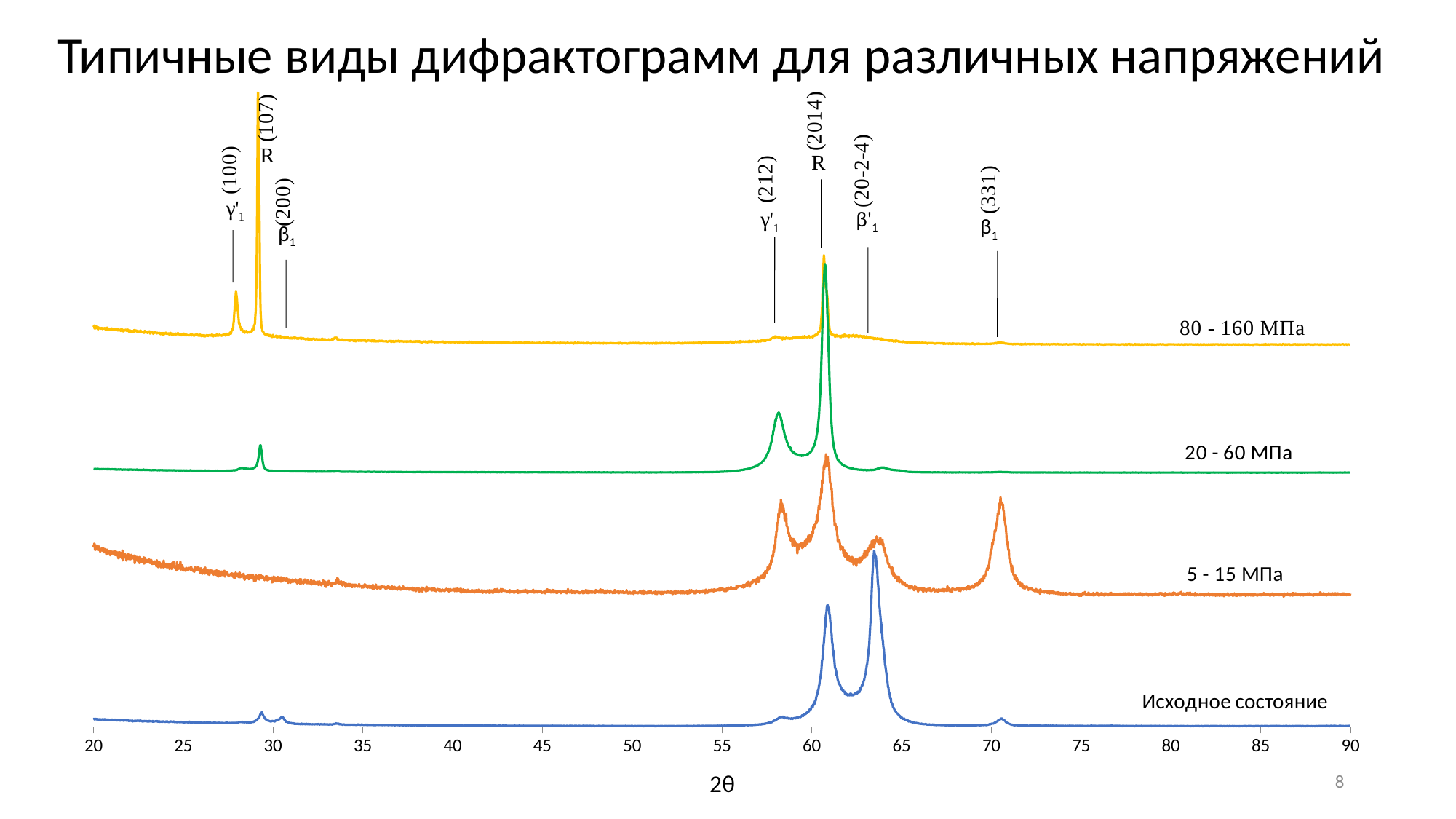
Is the 2θ position of the γ'1 (100) peak greater or less than 30? less Is the 2θ position of the R (2014) peak greater or less than 60? greater What kind of chart is shown on the slide? line chart What is the title of the chart on the slide? Типичные виды дифрактограмм для различных напряжений Is the 2θ position of the γ'1 (212) peak greater or less than 60? less Which curve is drawn at the bottom of the chart? Исходное состояние How many diffractogram curves are plotted on the chart? 4